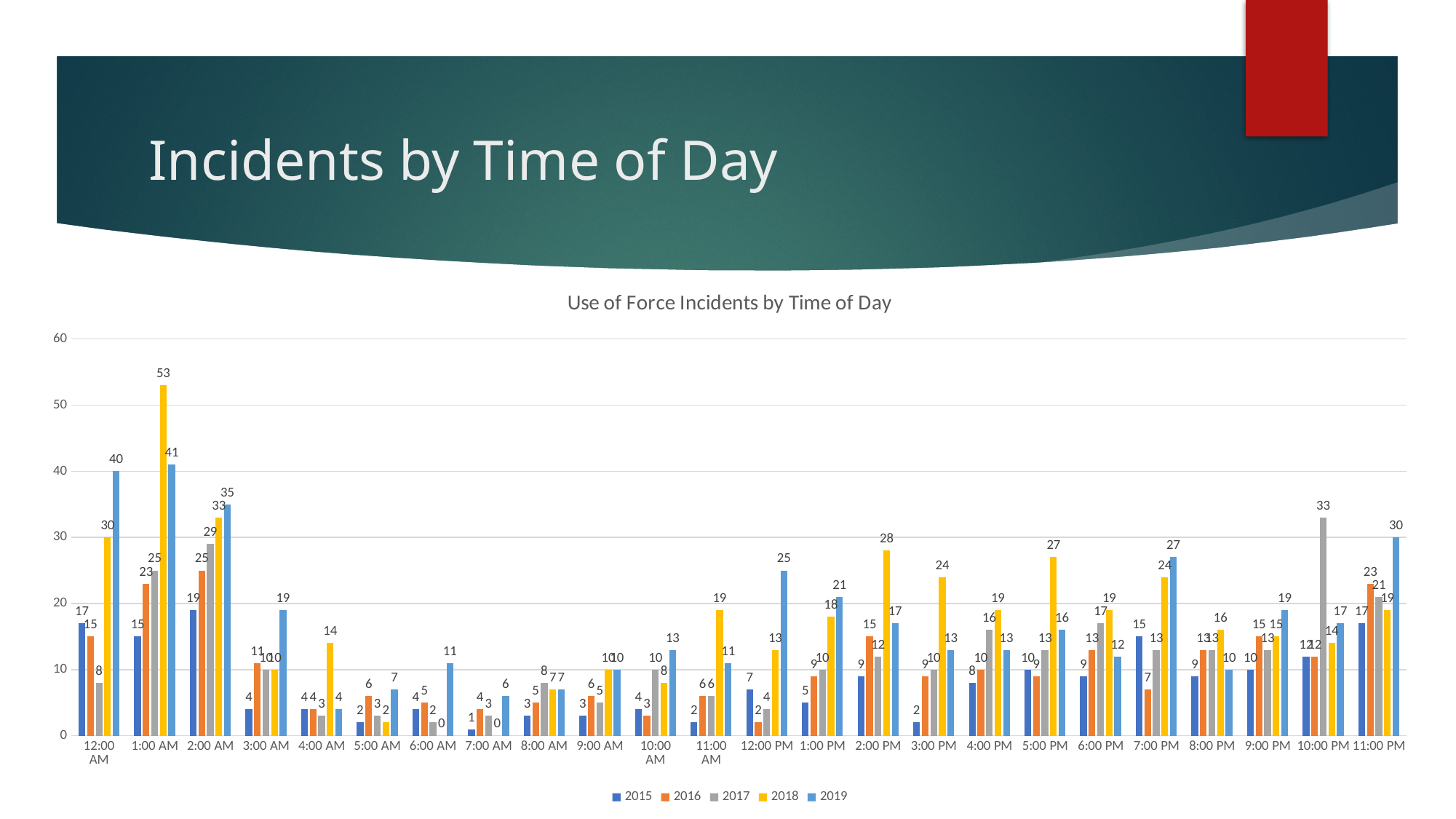
What kind of chart is shown on the slide? bar chart What is the title of the chart? Use of Force Incidents by Time of Day What is the value for 2019 at 12:00 PM? 25 How many series does the legend list? 5 What is the value for 2017 at 10:00 PM? 33 What is the difference between the 2018 and 2017 values at 2:00 PM? 16 What is the value for 2018 at 1:00 AM? 53 How many time-of-day categories are shown on the x axis? 24 At which time of day is the 2019 value lowest? 4:00 AM Which is larger, the 2019 value at 12:00 AM or the 2019 value at 11:00 PM? 12:00 AM What is the difference between the 2019 and 2015 values at 12:00 AM? 23 At which time of day is the 2018 value highest? 1:00 AM